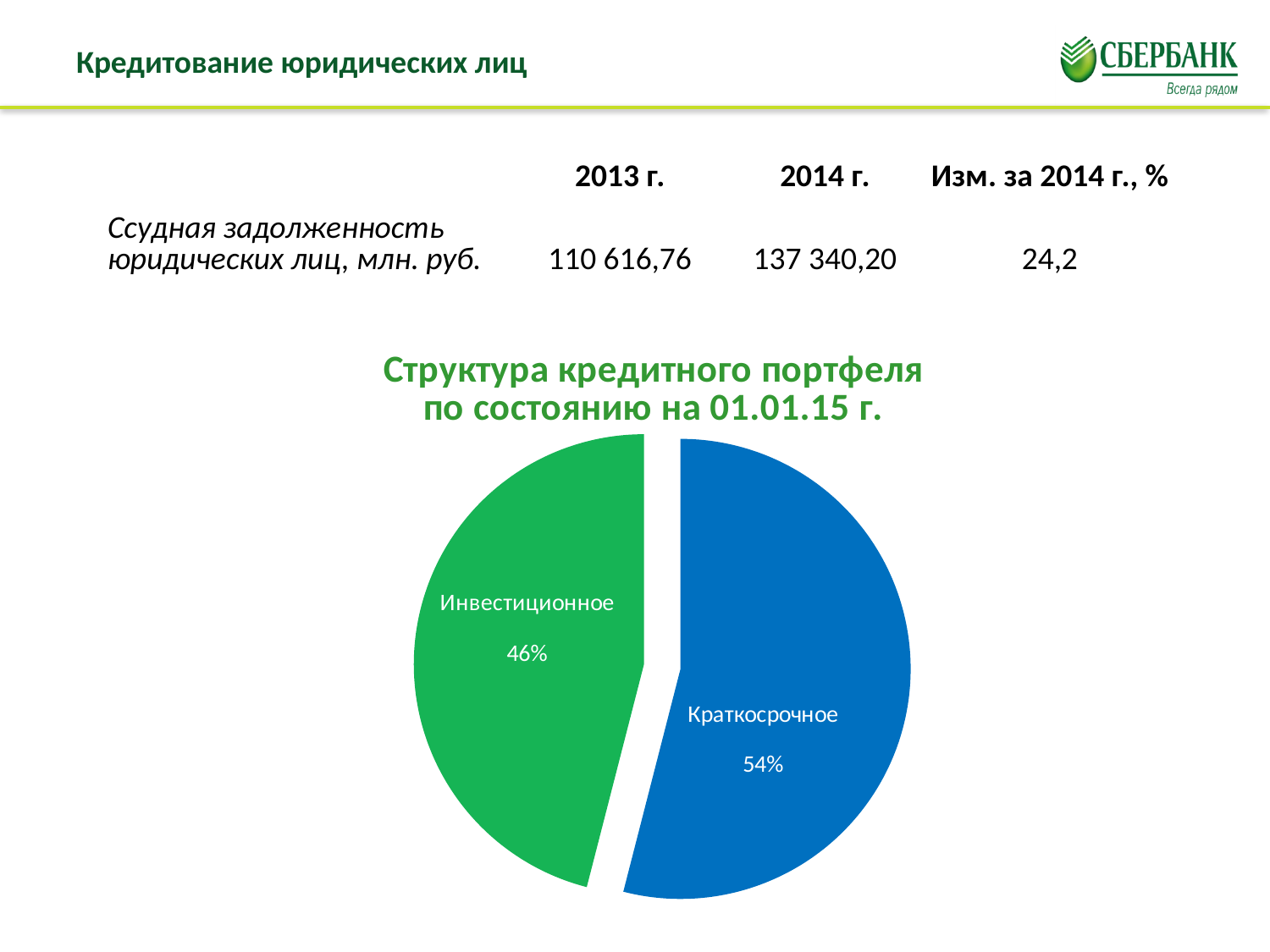
Which is larger, the Краткосрочное slice or the Инвестиционное slice? Краткосрочное What is the difference in percentage points between the Краткосрочное and Инвестиционное slices? 8 What share of the pie does Краткосрочное have? 54% How many slices does the pie chart have? 2 What share of the pie does Инвестиционное have? 46% What is the title of the pie chart? Структура кредитного портфеля по состоянию на 01.01.15 г. Which slice of the pie is the largest? Краткосрочное What kind of chart is shown on the slide? pie chart What colour is the Инвестиционное slice? green Is the share for Краткосрочное greater or less than 50%? greater Which slice of the pie is the smallest? Инвестиционное